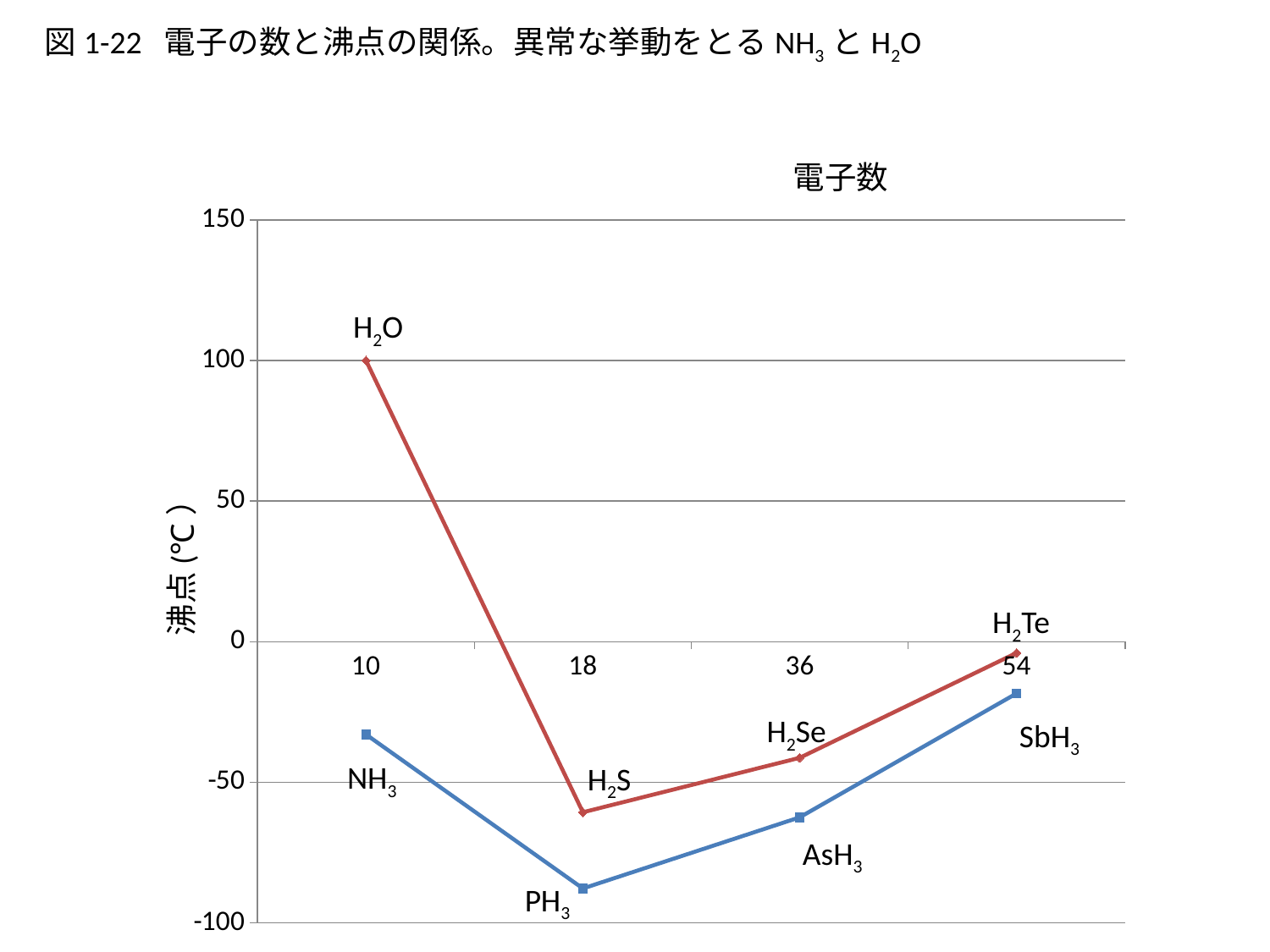
Is the boiling point of H2O greater or less than 50? greater Is the boiling point of NH3 greater or less than -50? greater Which compound has the lowest boiling point on the chart? PH3 How many data points does the blue line have? 4 Which compound has the highest boiling point on the chart? H2O How many data points does the red line have? 4 Is the boiling point of AsH3 greater or less than -50? less What is the label of the x axis? 電子数 What kind of chart is shown on the slide? line chart Which has the higher boiling point, H2Se or AsH3? H2Se Which has the higher boiling point, NH3 or PH3? NH3